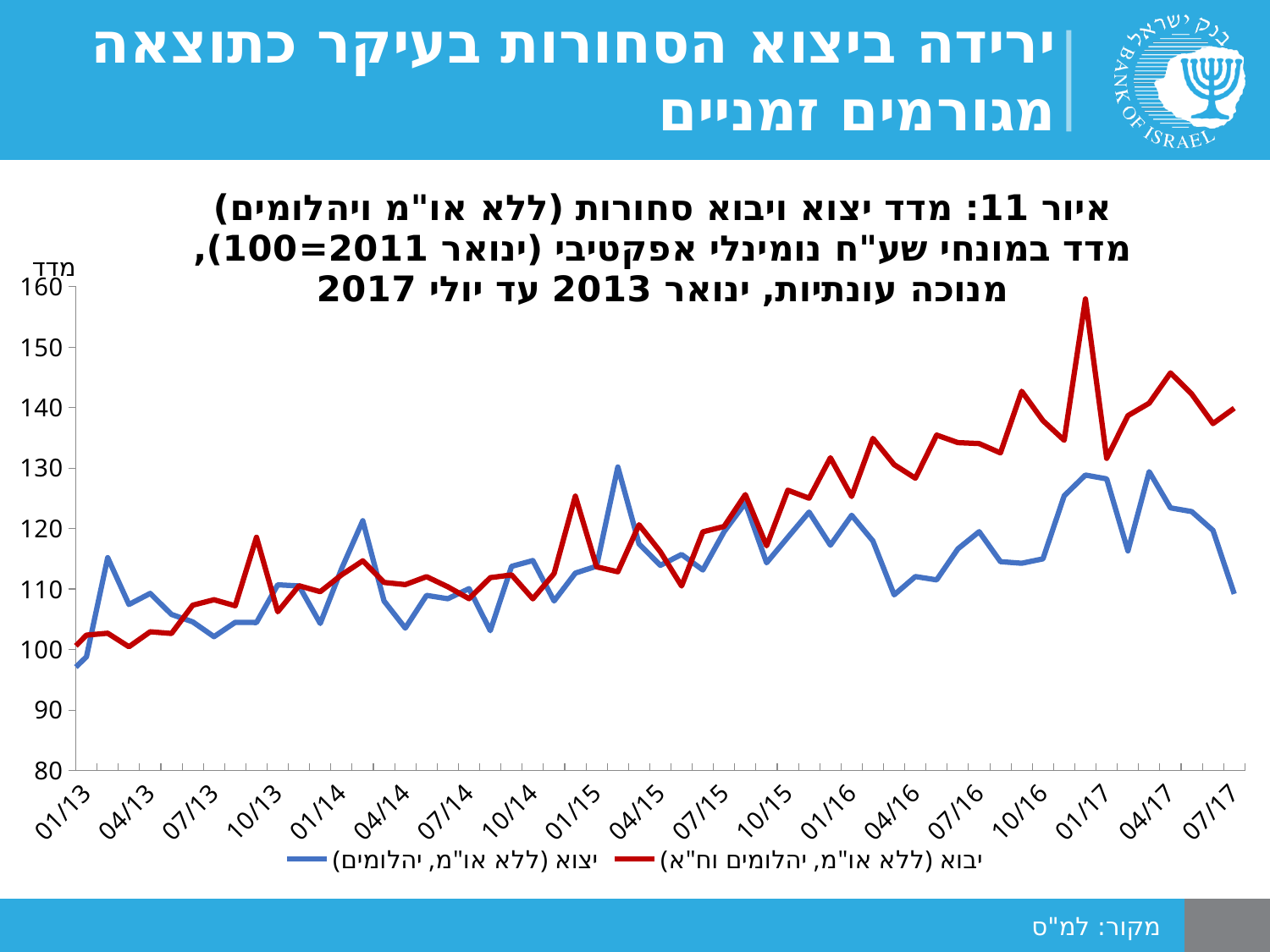
What kind of chart is shown on the slide? line chart Which series is drawn in blue? יצוא (ללא או"מ, יהלומים) At 07/17, which series has the higher value, exports (יצוא) or imports (יבוא)? imports (יבוא) How many series does the legend list? 2 Which series reaches the highest value anywhere on the chart? imports (יבוא) Which series is drawn in red? יבוא (ללא או"מ, יהלומים וח"א)